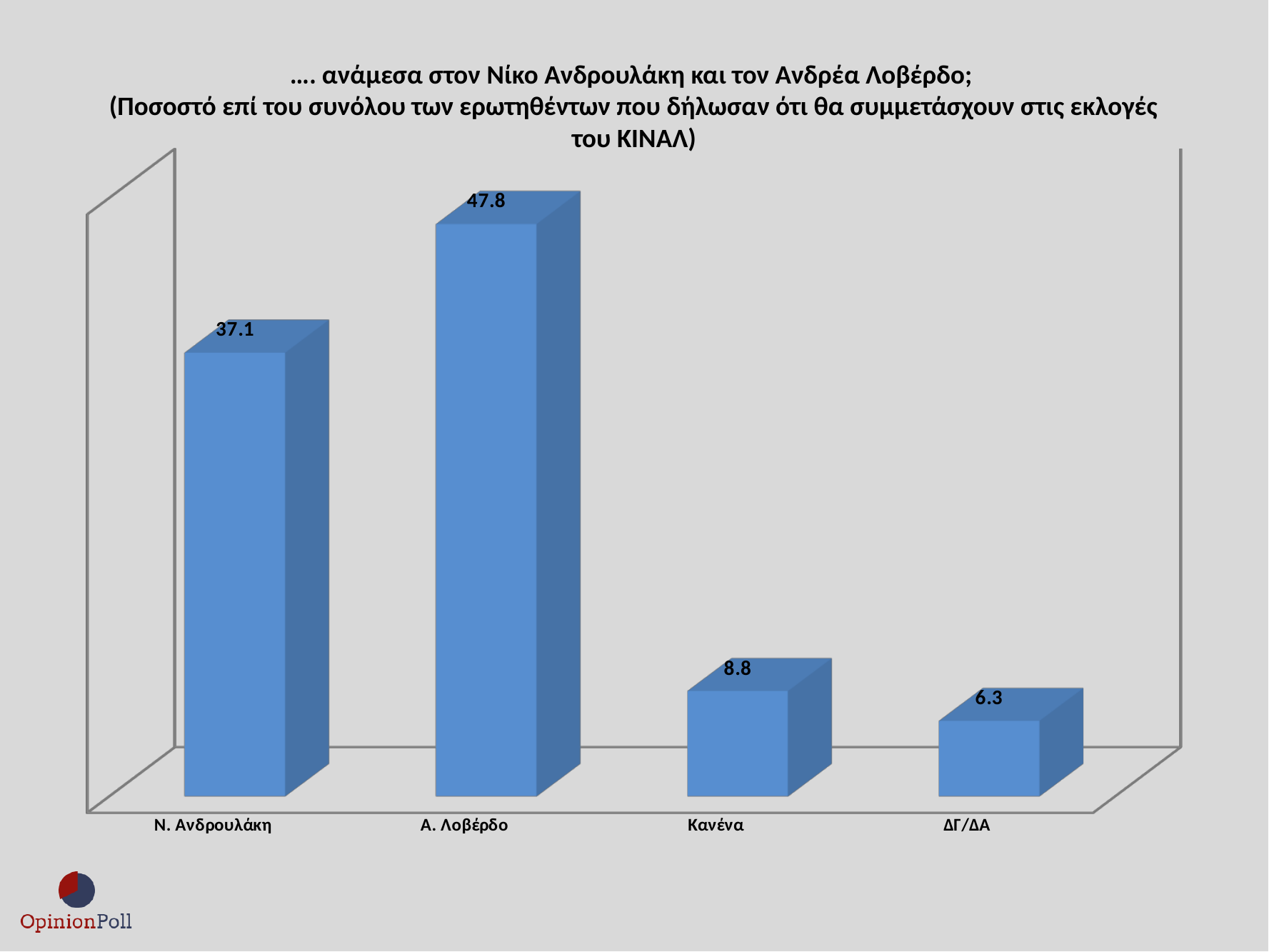
What is the difference between the values for Κανένα and ΔΓ/ΔΑ? 2.5 What is the difference between the values for Α. Λοβέρδο and Ν. Ανδρουλάκη? 10.7 What colour are the bars in the chart? Blue What kind of chart is shown on the slide? Bar chart How many categories are shown on the chart? 4 What is the value for Ν. Ανδρουλάκη? 37.1 What is the value for Κανένα? 8.8 Which category has the lowest value? ΔΓ/ΔΑ Which category has the highest value? Α. Λοβέρδο Which is larger, the value for Ν. Ανδρουλάκη or the value for Κανένα? Ν. Ανδρουλάκη What is the value for Α. Λοβέρδο? 47.8 What is the value for ΔΓ/ΔΑ? 6.3